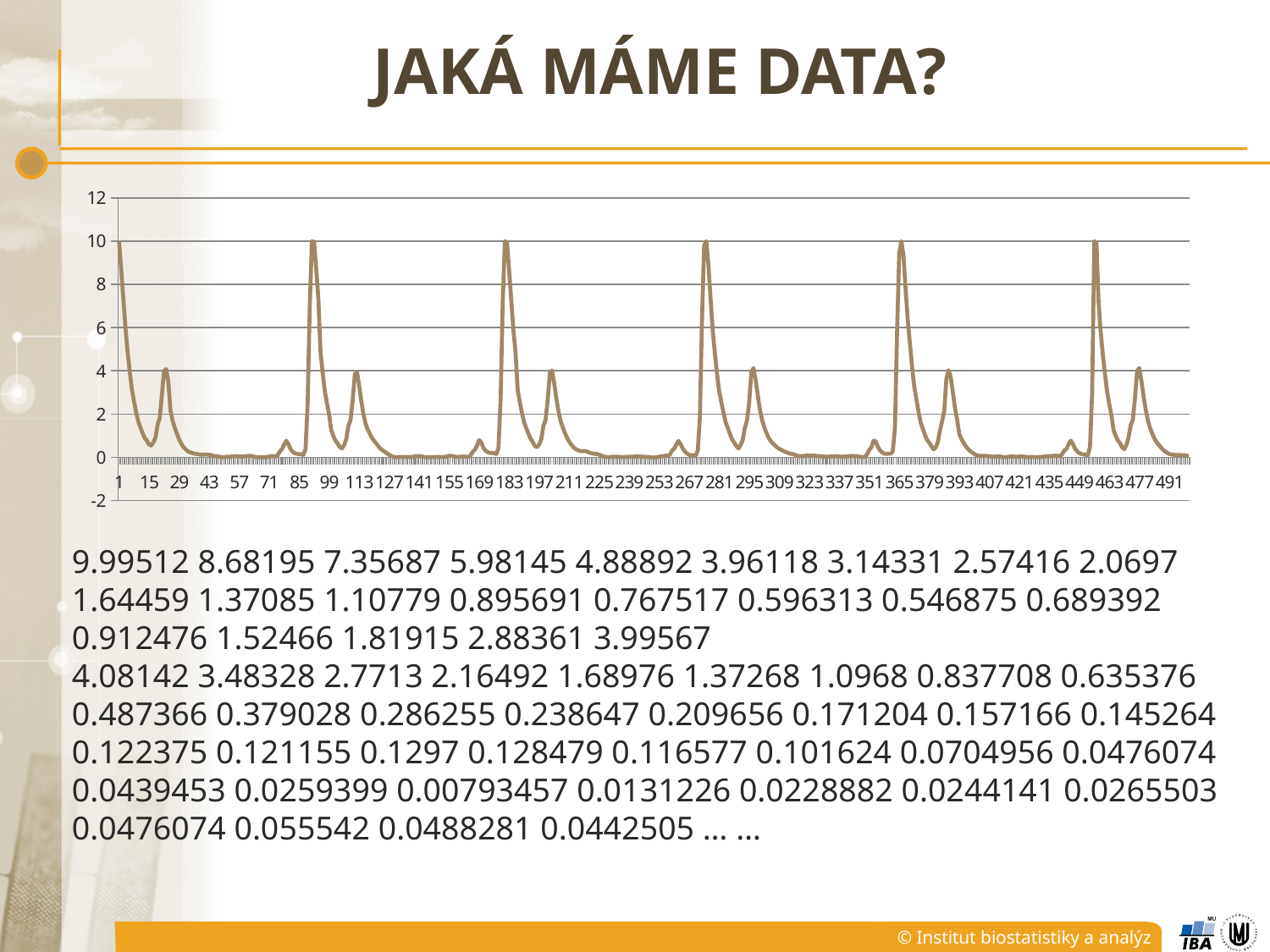
What kind of chart is shown on the slide? line chart What is the lowest value shown on the y axis of the chart? -2 Is the peak value near x = 113 greater or less than 6? less Which is larger, the value at x = 1 or the value at x = 57? the value at x = 1 Which is larger, the peak near x = 183 or the peak near x = 197? the peak near x = 183 Is the value at x = 43 greater or less than 2? less Is the value at x = 239 greater or less than 2? less What is the highest value shown on the y axis of the chart? 12 What is the last tick label shown on the x axis? 491 How many large peaks reaching about 10 does the line show? 6